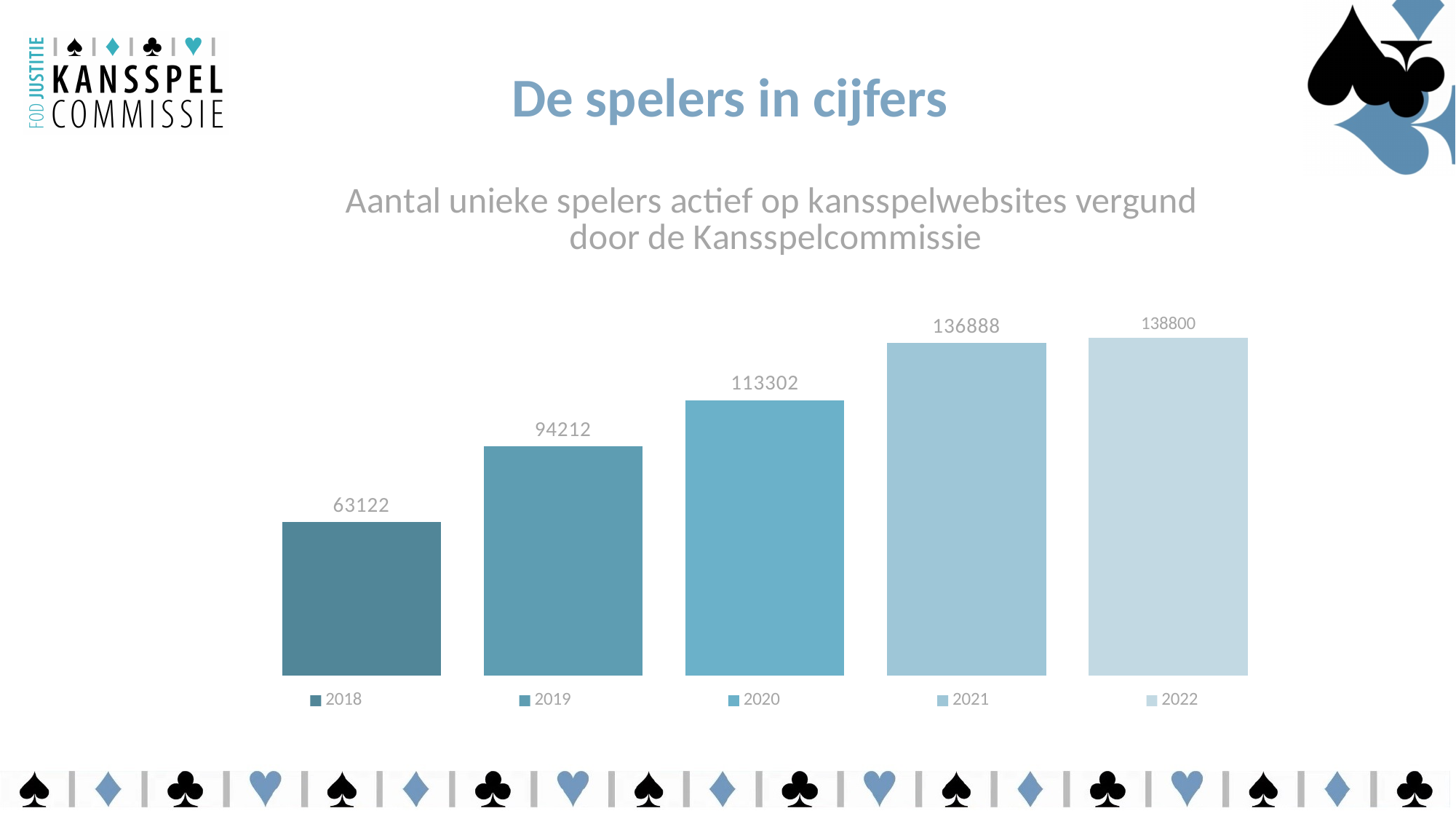
What is the number of unique players for 2020? 113302 Which year has the highest number of unique players? 2022 What is the number of unique players for 2018? 63122 Do the values rise or fall from 2018 to 2022? rise Which is larger, the value for 2020 or the value for 2019? 2020 What is the difference between the values for 2019 and 2018? 31090 What is the difference between the values for 2022 and 2021? 1912 What is the title of the chart? Aantal unieke spelers actief op kansspelwebsites vergund door de Kansspelcommissie What kind of chart is shown on the slide? bar chart Which year has the lowest number of unique players? 2018 How many years are shown in the chart? 5 What is the number of unique players for 2022? 138800